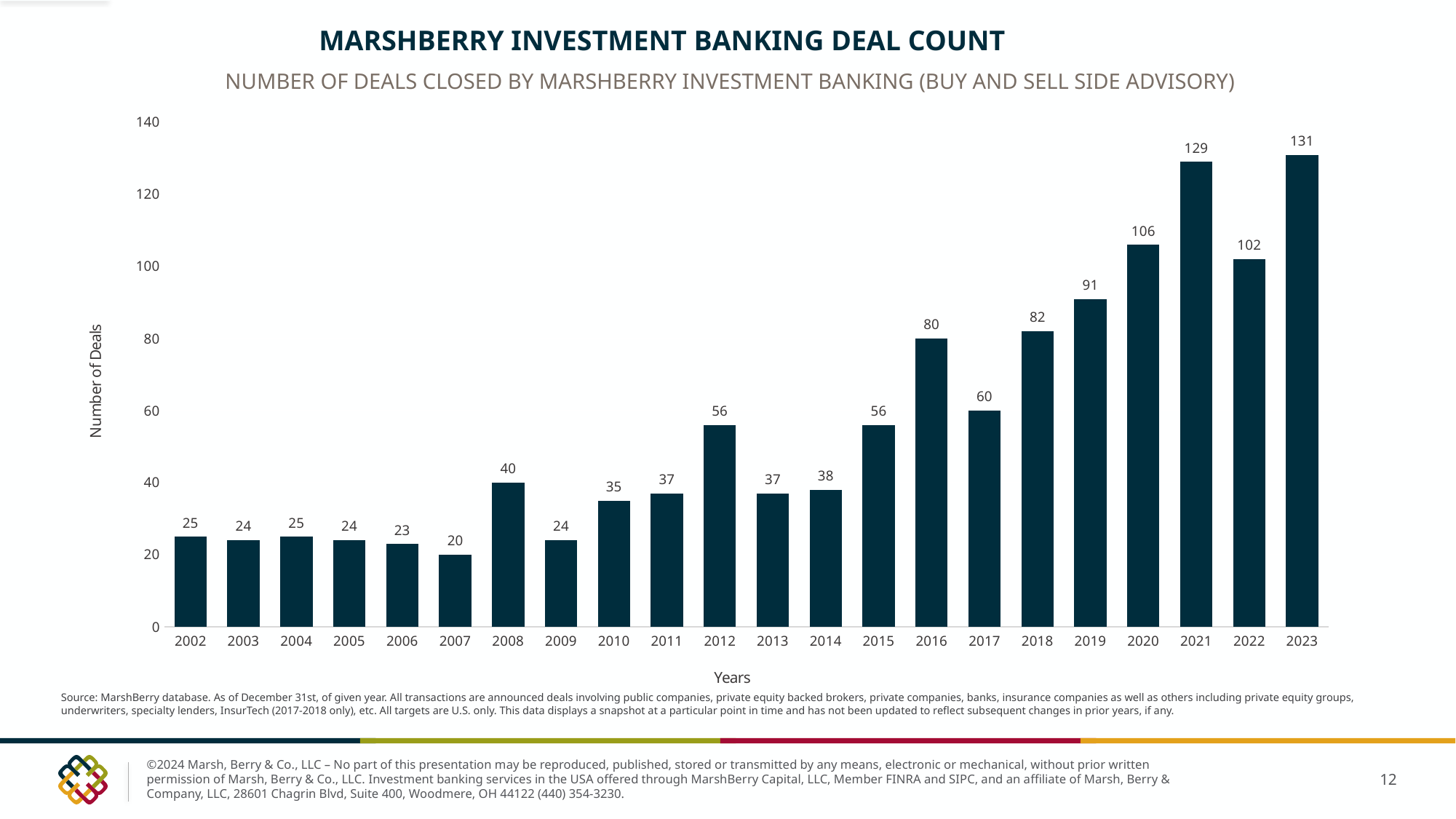
What is the difference in deal count between 2023 and 2002? 106 What is the number of deals shown for 2012? 56 What is the difference in deal count between 2021 and 2022? 27 Which year had more deals, 2016 or 2018? 2018 What is the label of the y axis? Number of Deals Do the deal counts generally rise or fall from 2002 to 2023? Rise What kind of chart is shown on the slide? Bar chart Which year has the lowest number of deals? 2007 Which year has the highest number of deals? 2023 What is the title of the chart? MARSHBERRY INVESTMENT BANKING DEAL COUNT How many deals were closed in 2023? 131 How many years are shown on the x axis? 22